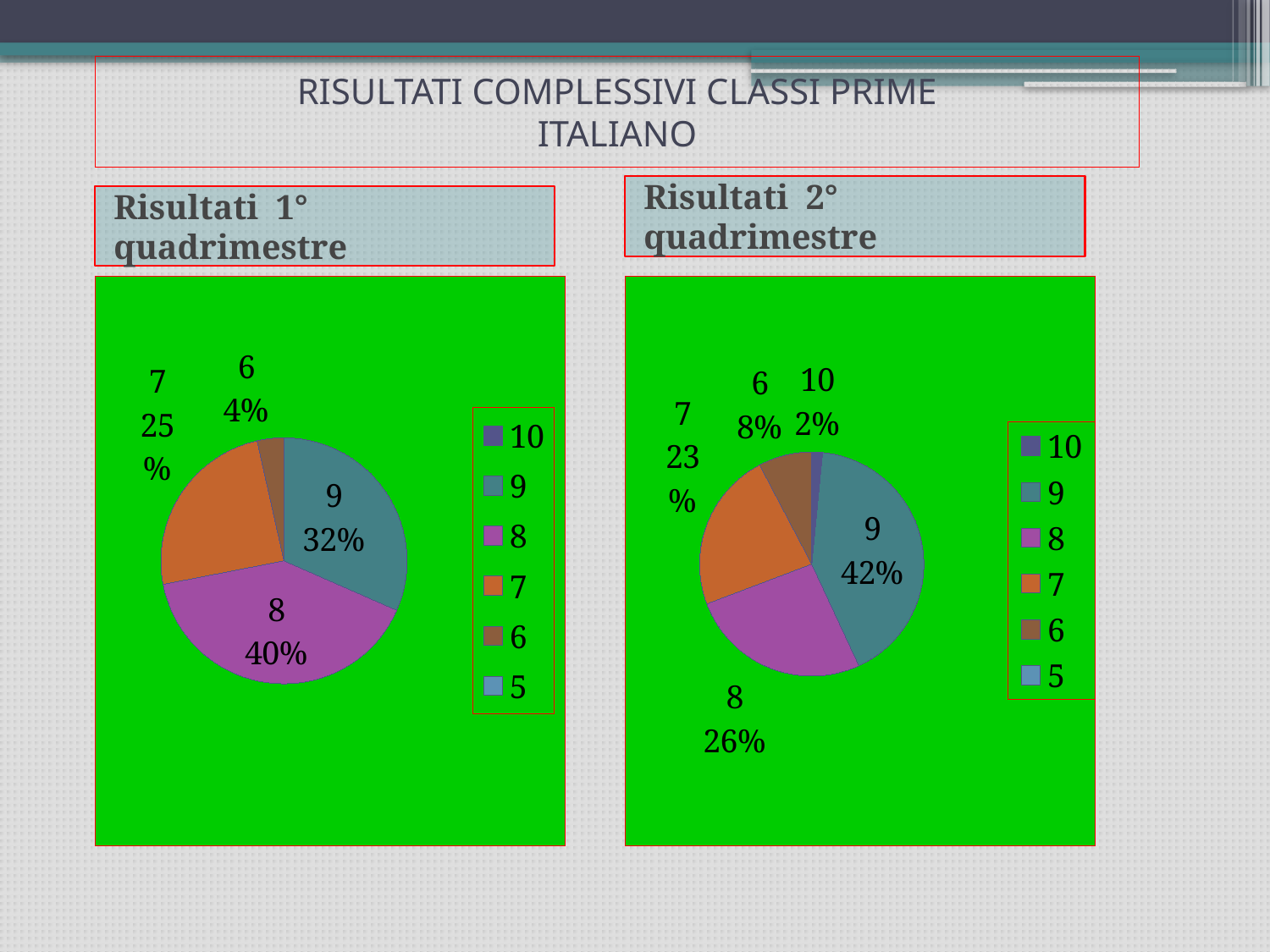
In the 'Risultati 1° quadrimestre' chart, what share does grade 9 have? 32% How many entries does the legend of the 'Risultati 2° quadrimestre' chart list? 6 What type of chart is used for the 'Risultati 1° quadrimestre' results? pie chart In the 'Risultati 2° quadrimestre' chart, what share does grade 10 have? 2% In the 'Risultati 1° quadrimestre' chart, what share does grade 8 have? 40% In the 'Risultati 1° quadrimestre' chart, what is the difference between the shares of grade 8 and grade 7? 15% In the 'Risultati 2° quadrimestre' chart, which is larger, the share of grade 8 or the share of grade 7? grade 8 In the 'Risultati 2° quadrimestre' chart, what is the difference between the shares of grade 9 and grade 8? 16% In the 'Risultati 1° quadrimestre' chart, which labelled grade has the smallest slice? 6 In the 'Risultati 2° quadrimestre' chart, which grade has the largest slice? 9 In the 'Risultati 1° quadrimestre' chart, which grade has the largest slice? 8